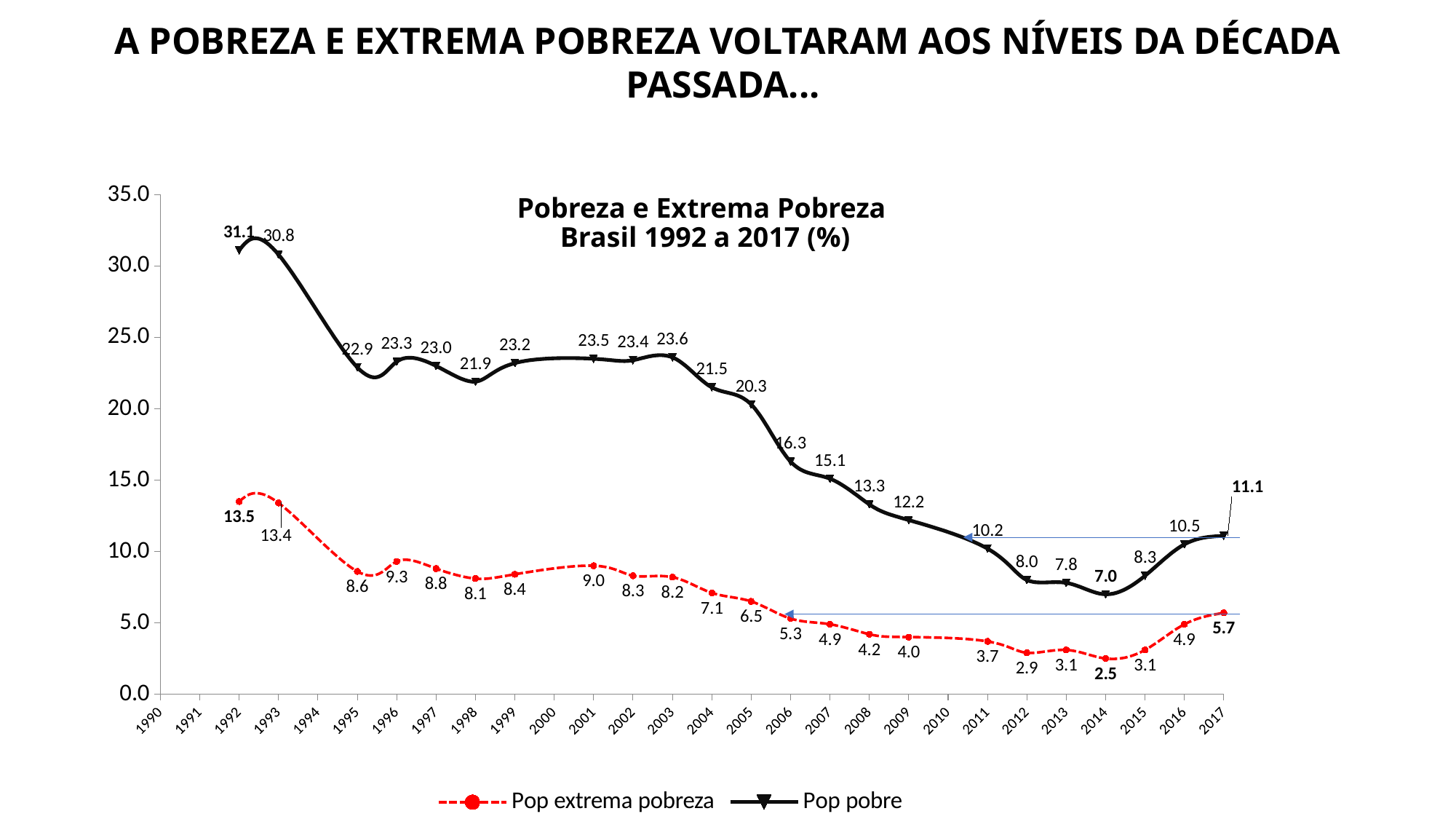
What kind of chart is shown? Line chart In which year is Pop pobre at its lowest? 2014 Which is larger, Pop pobre in 2016 or in 2011? 2016 What is the difference between Pop pobre in 1992 and in 2017? 20.0 What is the value of Pop extrema pobreza in 2014? 2.5 What is the value of Pop extrema pobreza in 2006? 5.3 In which year is Pop extrema pobreza at its lowest? 2014 What is the value of Pop pobre in 2017? 11.1 How many series does the legend list? 2 In which year is Pop pobre at its highest? 1992 Does Pop pobre rise or fall from 2014 to 2017? Rise By how much did Pop extrema pobreza increase from 2014 to 2017? 3.2